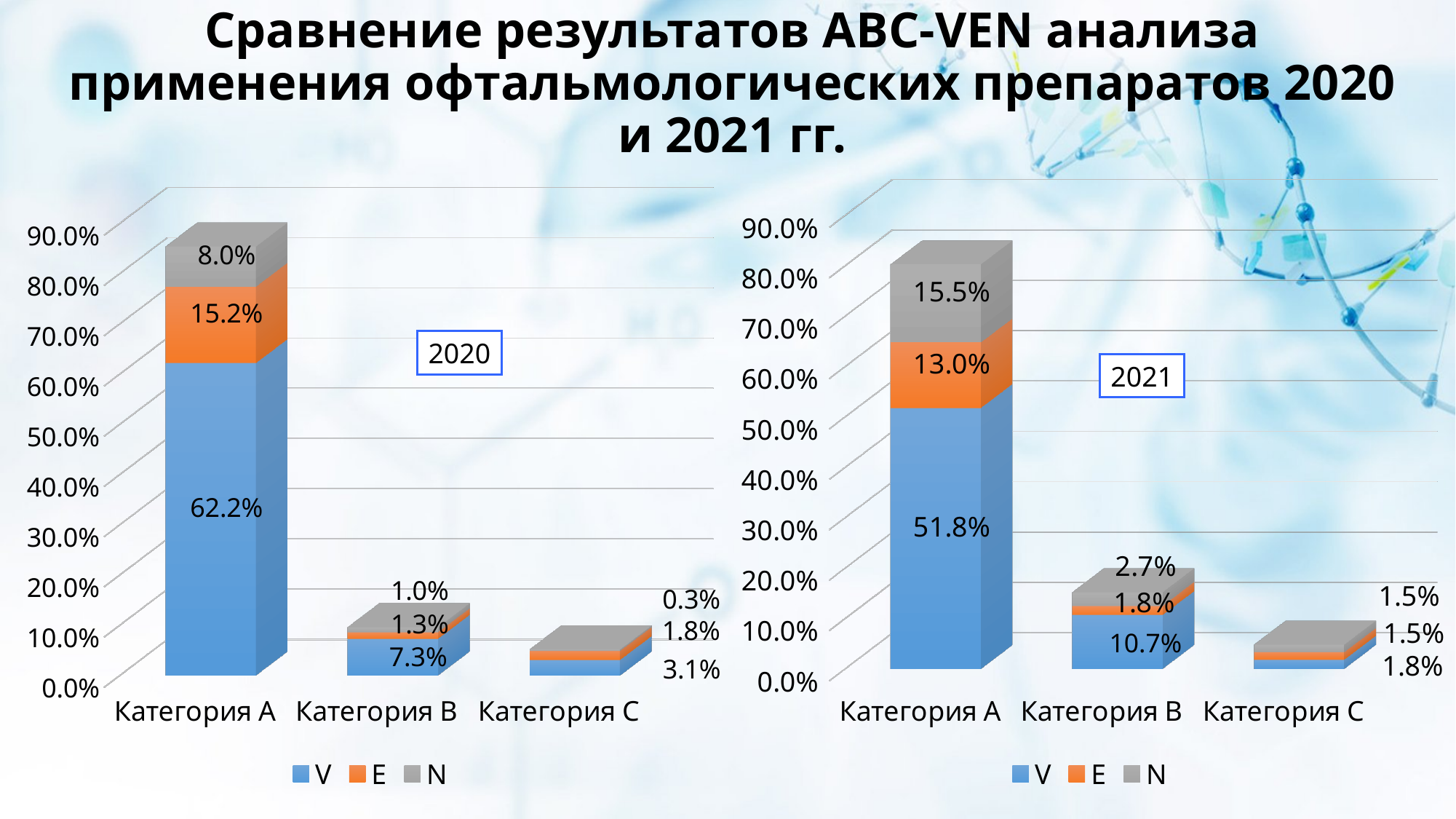
In the 2020 chart, what is the value of series V for Категория A? 62.2% What type of chart is the 2021 chart? Stacked bar chart What is the difference between the series V value for Категория A in the 2020 chart and in the 2021 chart? 10.4 percentage points How many series does the legend of the 2020 chart list? 3 In the 2021 chart, what is the total of the stacked bar for Категория A? 80.3% In the 2021 chart, which category has the lowest value for series V? Категория C In the 2021 chart, what is the value of series N for Категория A? 15.5% In the 2021 chart, which is larger for Категория A: series E or series N? N In the 2021 chart, what is the value of series V for Категория B? 10.7% In the 2020 chart, what is the total of the stacked bar for Категория A? 85.4% In the 2020 chart, which category has the highest value for series V? Категория A In the 2020 chart, what is the value of series E for Категория C? 1.8%